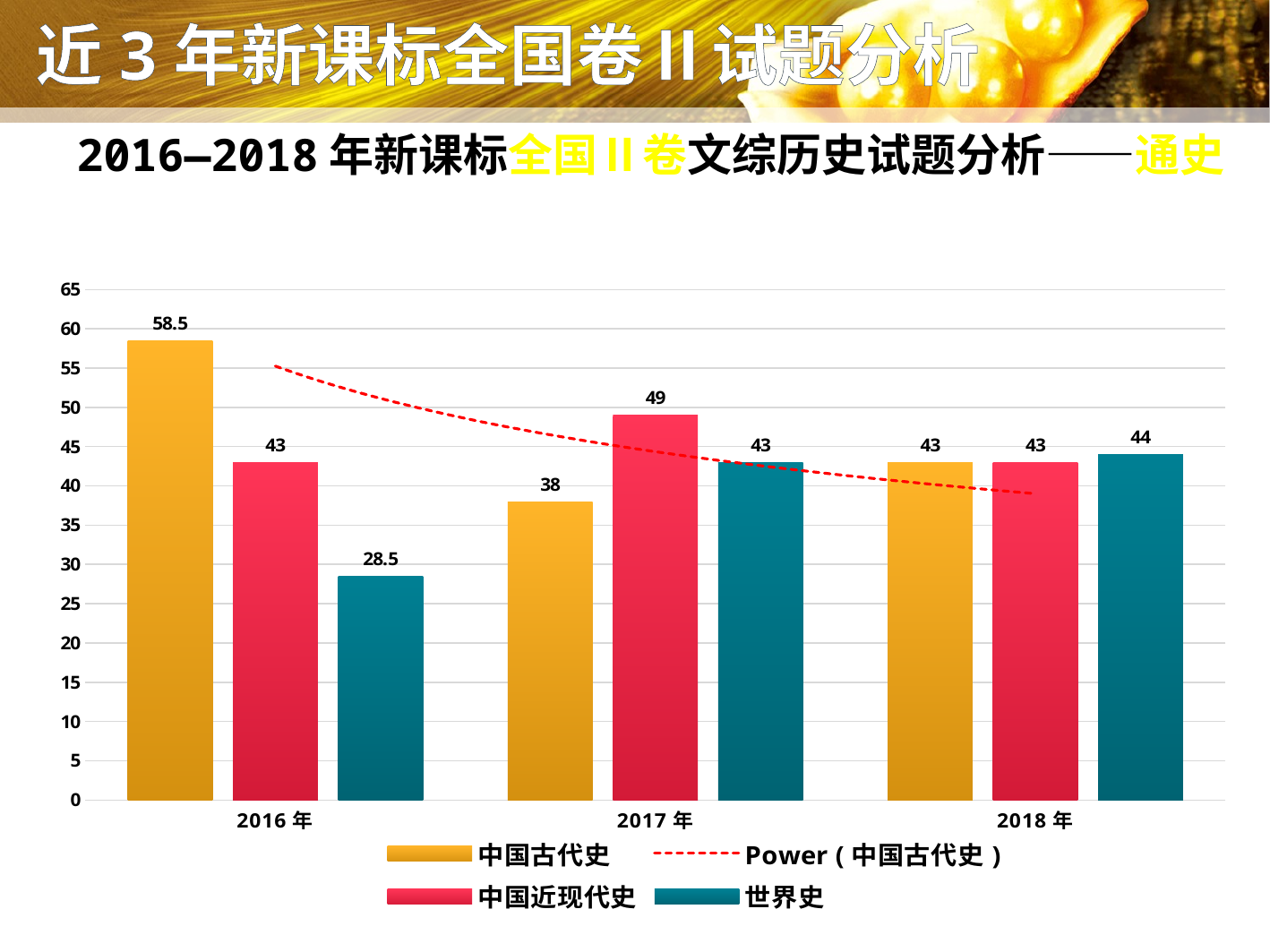
What is the value for 中国古代史 in 2016年? 58.5 What is the difference between 中国古代史 and 世界史 in 2016年? 30 Which is larger in 2017年, 中国古代史 or 中国近现代史? 中国近现代史 In which year is the value for 中国古代史 the highest? 2016年 In which year is the value for 世界史 the lowest? 2016年 How many entries does the legend list? 4 Does the value for 中国古代史 rise or fall from 2016年 to 2017年? fall What is the value for 世界史 in 2016年? 28.5 What is the value for 世界史 in 2018年? 44 How many years are shown on the x axis? 3 What kind of chart is shown on the slide? bar chart What is the value for 中国近现代史 in 2017年? 49